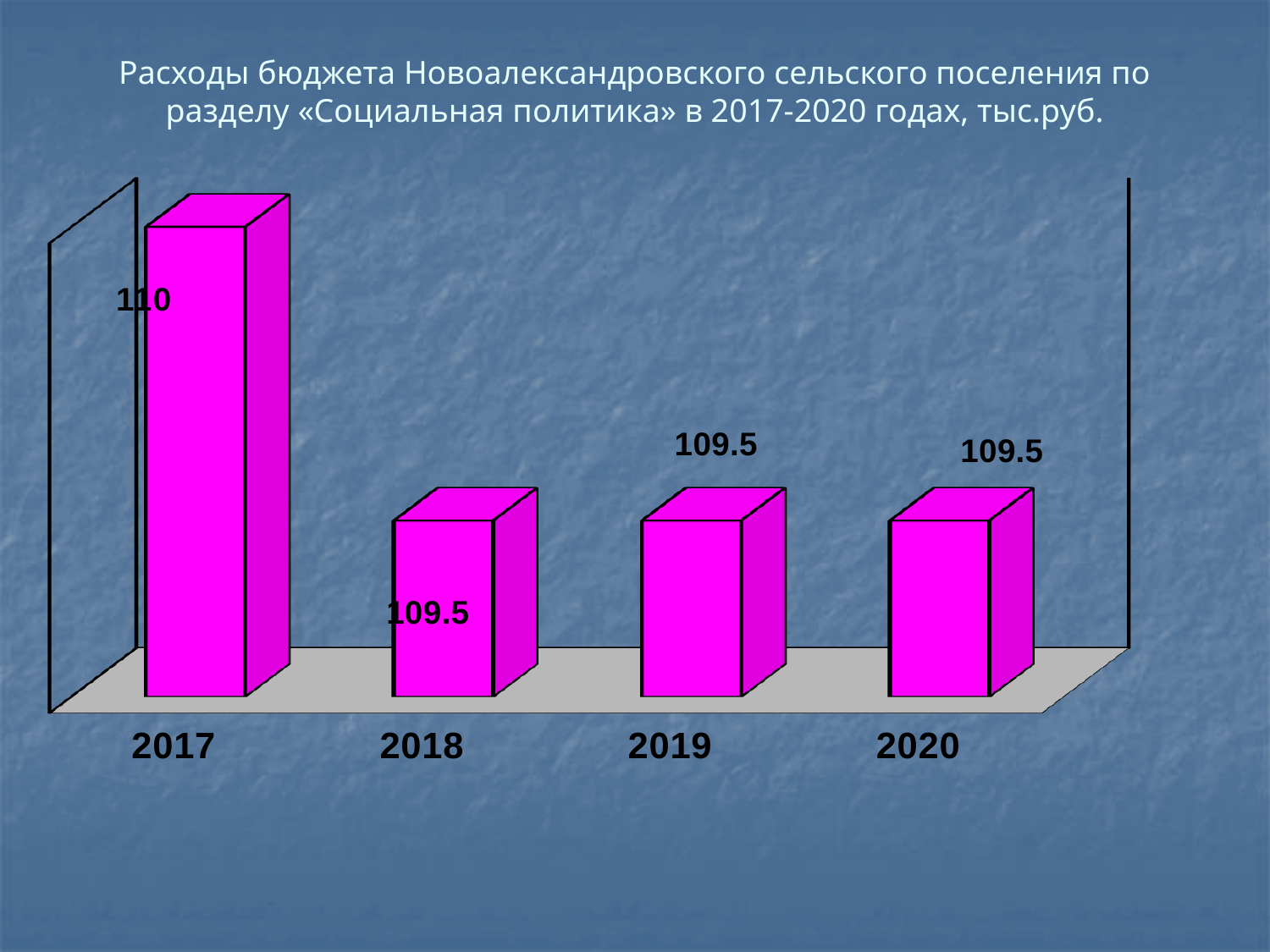
What is the value for 2017? 110 What is the value for 2018? 109.5 Does the value rise or fall from 2017 to 2018? fall Which is larger, the value for 2017 or the value for 2020? 2017 What colour are the bars in the chart? magenta How many years are shown on the x axis? 4 What is the value for 2020? 109.5 What is the value for 2019? 109.5 What is the difference between the values for 2017 and 2018? 0.5 What kind of chart is shown on the slide? bar chart Which year has the highest value? 2017 What unit of measurement is stated in the chart title? тыс.руб.